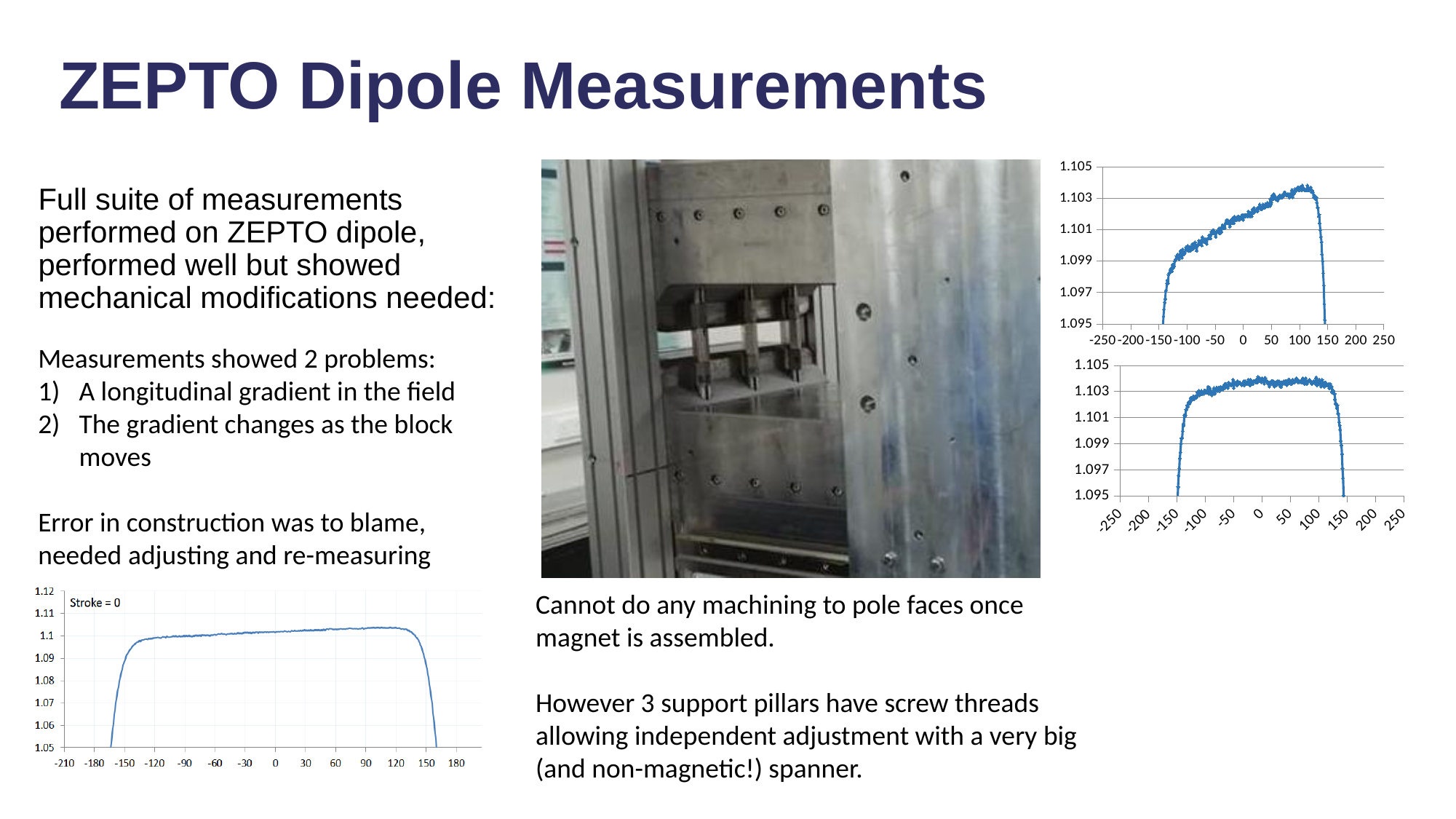
In the top-right chart, is the value at x = 100 greater or less than 1.101? greater How many charts are shown on the slide? 3 In the top-right chart, is the value at x = 0 greater or less than 1.099? greater What kind of chart is the bottom-left chart labelled 'Stroke = 0'? line chart In the top-right chart, is the value at x = -100 greater or less than 1.101? less What text label appears inside the bottom-left chart? Stroke = 0 What is the lowest value shown on the y axis of the top-right chart? 1.095 What kind of chart is the top-right chart? line chart In the top-right chart, does the value rise or fall as x goes from -150 to 100? rise